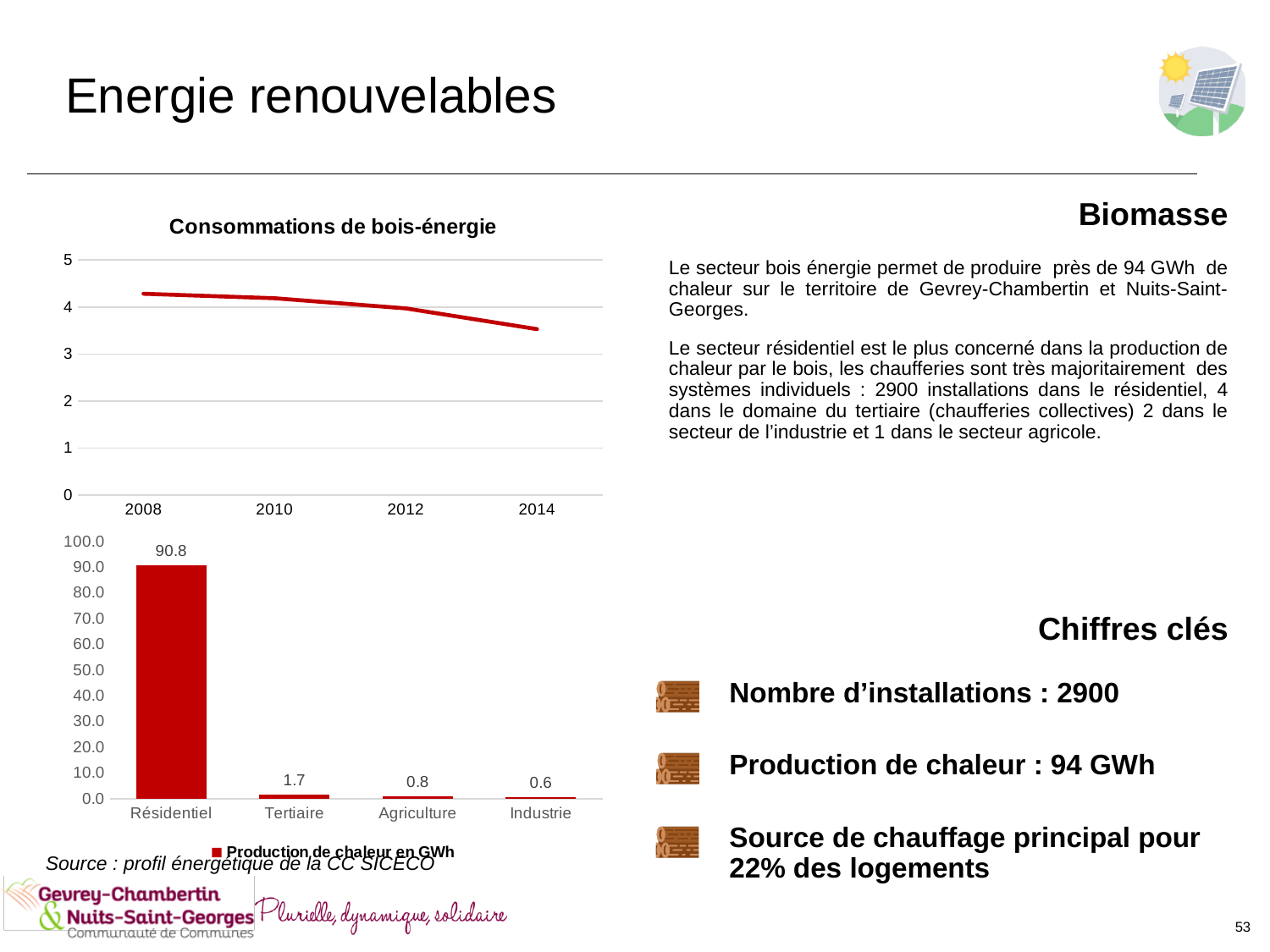
In the bar chart at the bottom left, how many categories are shown on the x axis? 4 In the bar chart at the bottom left, what is the value for Industrie? 0.6 In the chart titled 'Consommations de bois-énergie', do the values rise or fall from 2008 to 2014? fall In the bar chart at the bottom left, what is the value for Résidentiel? 90.8 In the bar chart at the bottom left, which category has the highest value? Résidentiel In the bar chart at the bottom left, what is the value for Agriculture? 0.8 In the chart titled 'Consommations de bois-énergie', is the value for 2008 greater or less than 4? greater What kind of chart is the chart titled 'Consommations de bois-énergie'? line chart In the bar chart at the bottom left, what is the difference between the values for Résidentiel and Tertiaire? 89.1 In the bar chart at the bottom left, what is the value for Tertiaire? 1.7 In the bar chart at the bottom left, which category has the lowest value? Industrie In the bar chart at the bottom left, what series name does the legend show? Production de chaleur en GWh